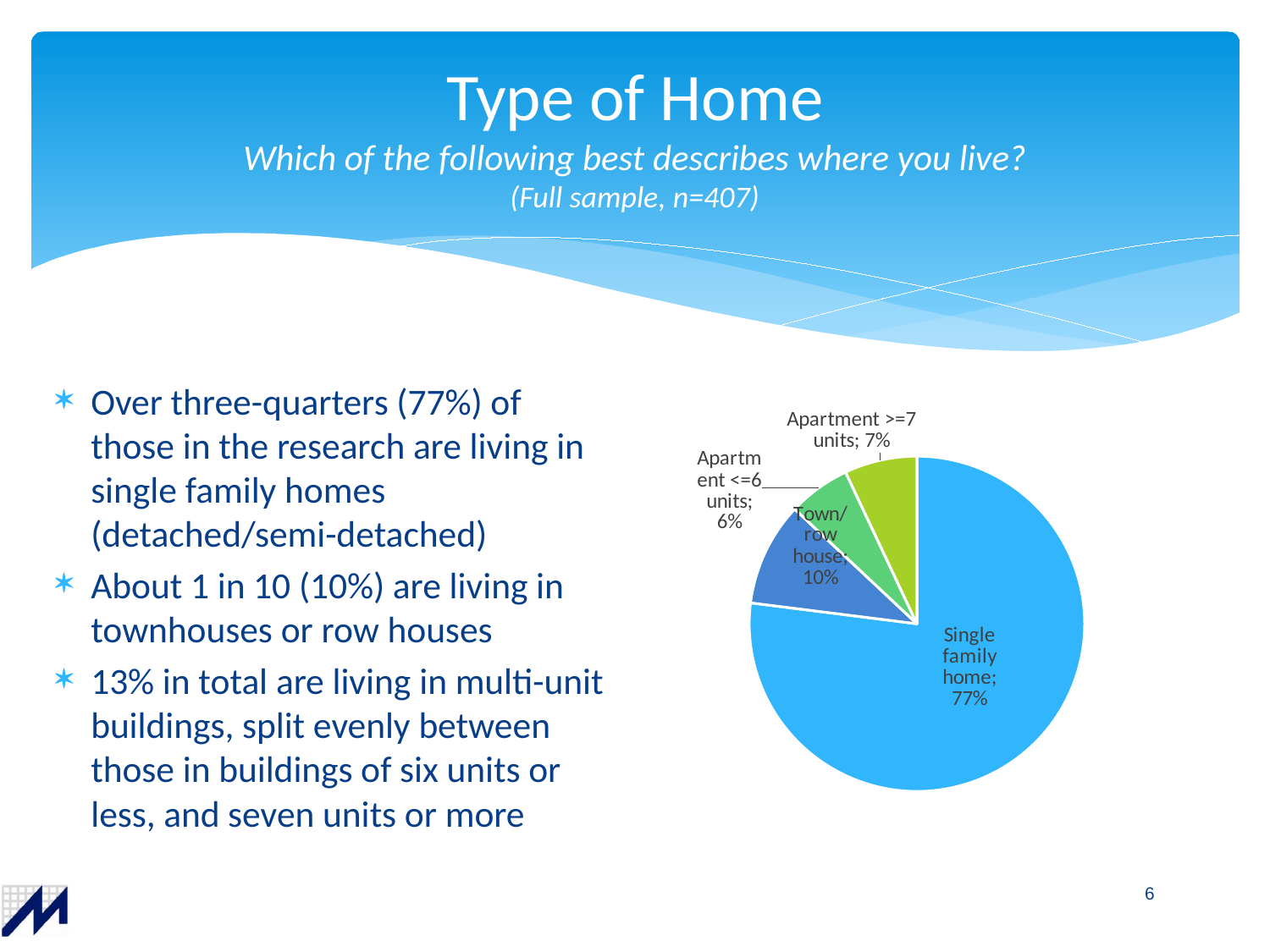
What is the value for Apartment >=7 units? 7% What is the difference between the Single family home share and the Town/row house share? 67 percentage points What is the value for Apartment <=6 units? 6% Which category has the smallest slice of the pie? Apartment <=6 units How many slices does the pie chart have? 4 Which category has the largest slice of the pie? Single family home What kind of chart is shown on the slide? Pie chart Which is larger, the share for Town/row house or the share for Apartment >=7 units? Town/row house What share of the pie is Single family home? 77% What is the combined share of the two apartment categories? 13% What percentage of respondents live in a Town/row house? 10% What colour is the Single family home slice? Light blue